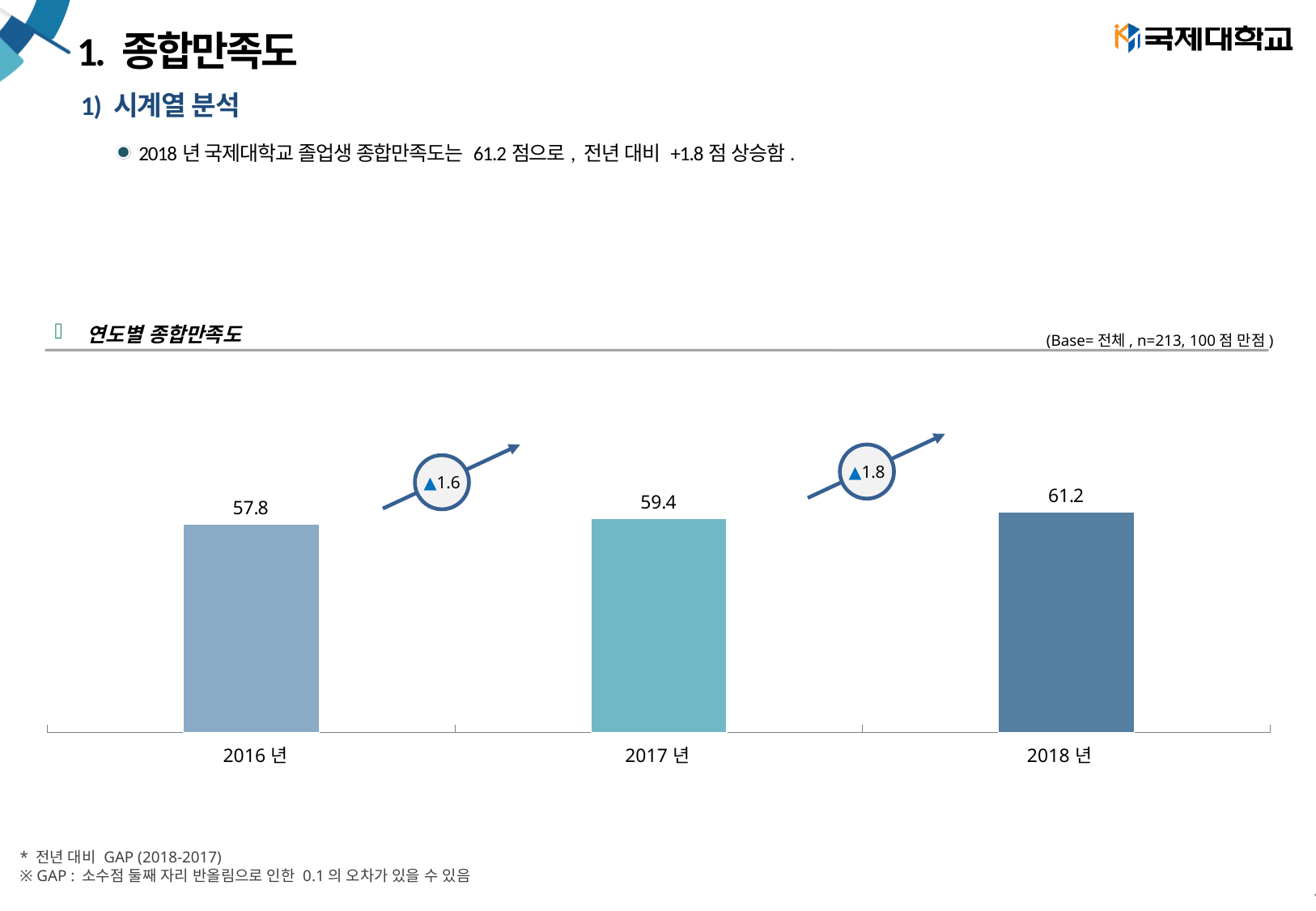
How many years are shown on the chart? 3 What is the value for 2018년? 61.2 What is the value for 2017년? 59.4 Do the values rise or fall from 2016년 to 2018년? rise Which is larger, the value for 2016년 or the value for 2018년? 2018년 What is the difference between the values for 2018년 and 2017년? 1.8 Which year has the highest value? 2018년 What is the difference between the values for 2017년 and 2016년? 1.6 What kind of chart is shown? bar chart What is the value for 2016년? 57.8 What is the title of the chart? 연도별 종합만족도 Which year has the lowest value? 2016년